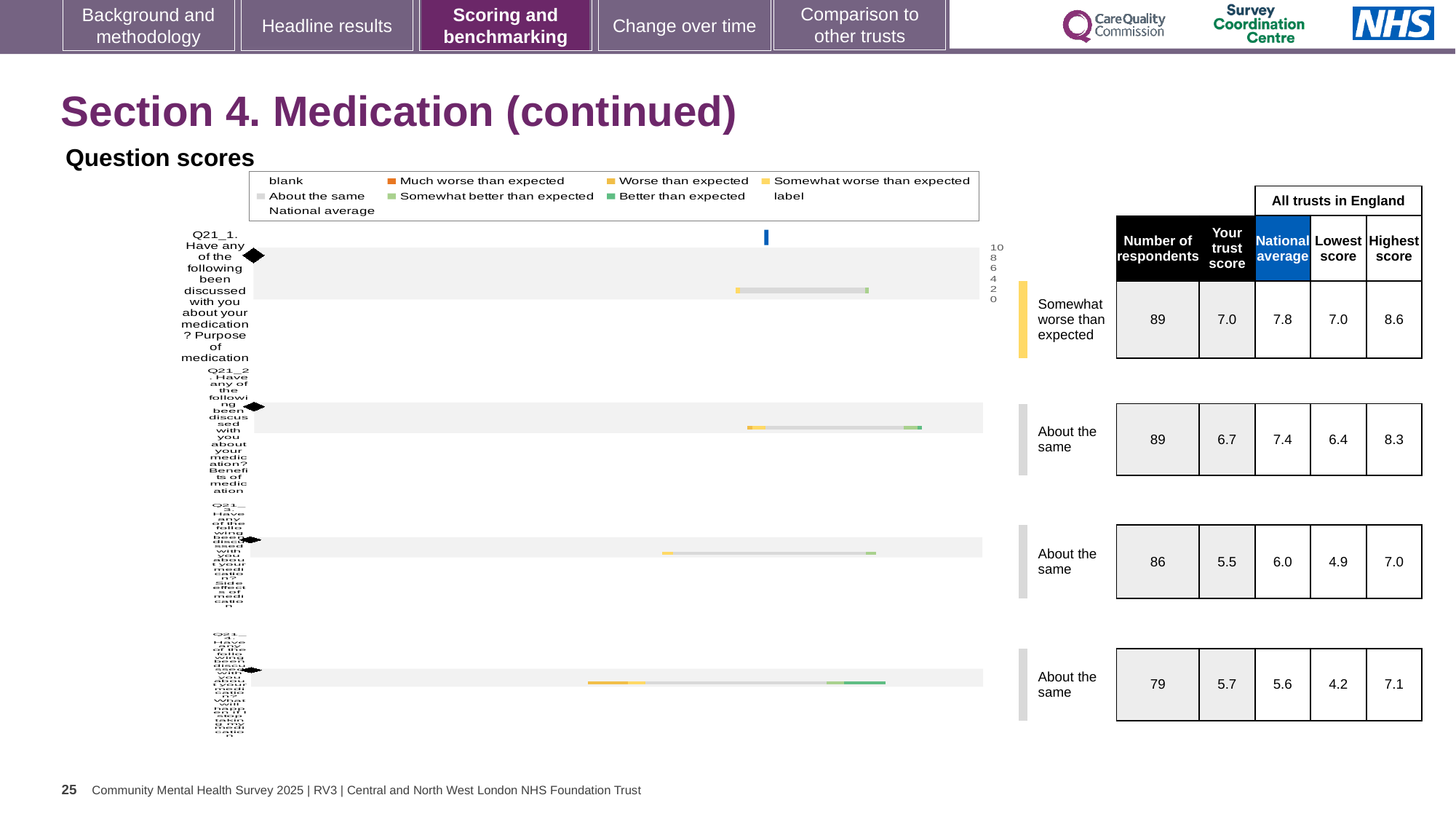
What is the difference between the national average and the trust score for Q21_1 in the table beside the chart? 0.8 Which question row has the lowest 'Your trust score' in the table beside the chart? Q21_3 (Side effects of medication) In the table beside the chart, what is the national average for Q21_2 (Benefits of medication)? 7.4 In the chart legend, what colour represents 'Better than expected'? green What benchmark label is shown next to the Q21_1 bar? Somewhat worse than expected In the table beside the chart, how many respondents answered Q21_4 (What might happen if I stop taking medication)? 79 How many question bars (Q21_1 to Q21_4) are plotted in the chart? 4 In the table beside the chart, what is the highest score for Q21_3 (Side effects of medication)? 7.0 In the table beside the chart, what is the 'Your trust score' for Q21_1 (Purpose of medication)? 7.0 What kind of chart is shown under 'Question scores'? bar chart Is the trust score for Q21_4 larger or smaller than its national average in the table beside the chart? larger In the chart legend, what colour represents 'Much worse than expected'? orange